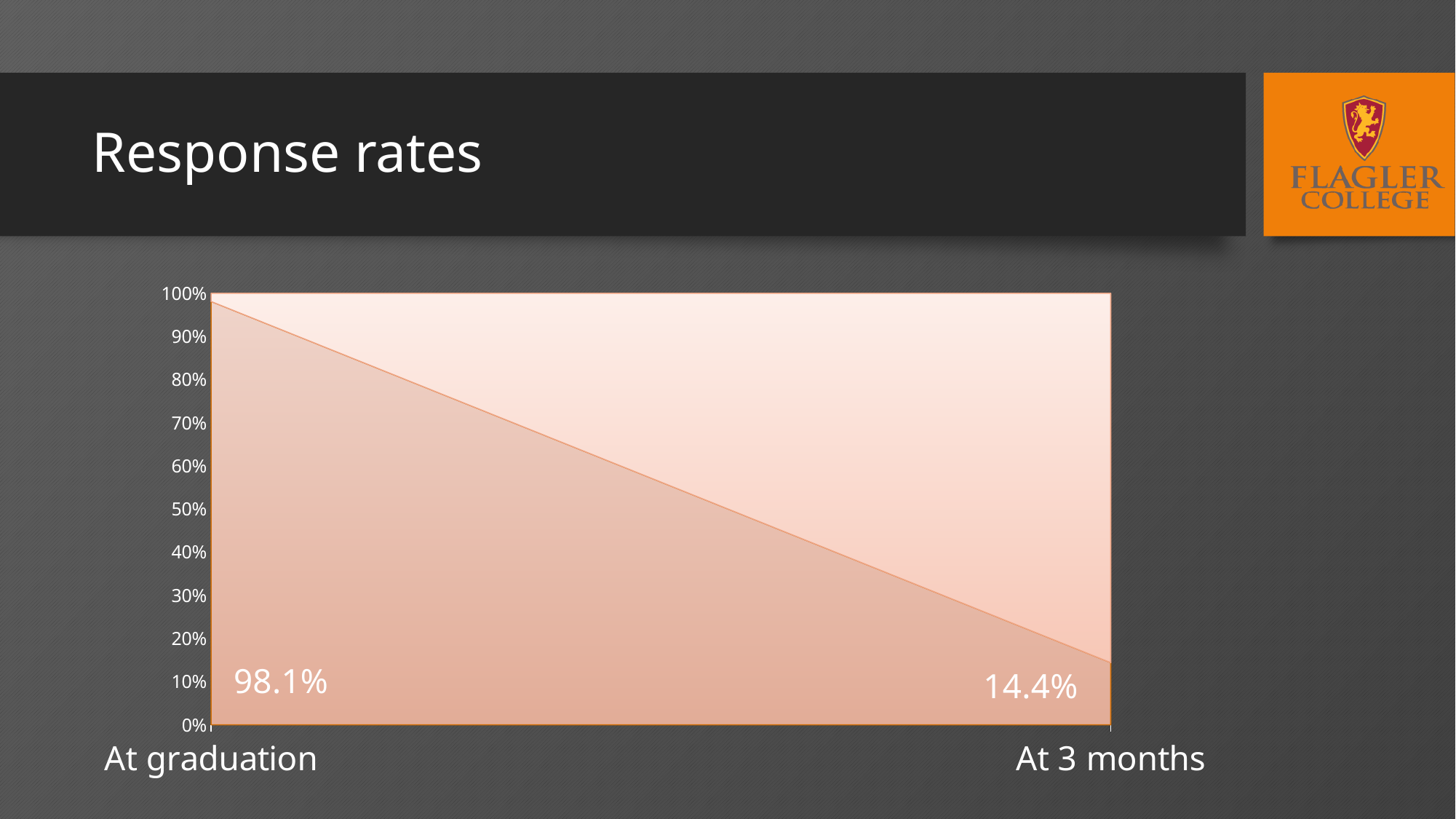
Is the response rate at 3 months greater or less than 20%? less Which is larger, the response rate at graduation or at 3 months? At graduation What is the title of the slide containing the chart? Response rates What is the response rate at graduation? 98.1% Do the values rise or fall from left to right along the x axis? fall How many categories are shown on the x axis? 2 What is the response rate at 3 months? 14.4% What kind of chart is shown on the slide? area chart Which category has the highest response rate? At graduation Which category has the lowest response rate? At 3 months What is the difference between the response rate at graduation and at 3 months? 83.7% Is the response rate at graduation greater or less than 90%? greater